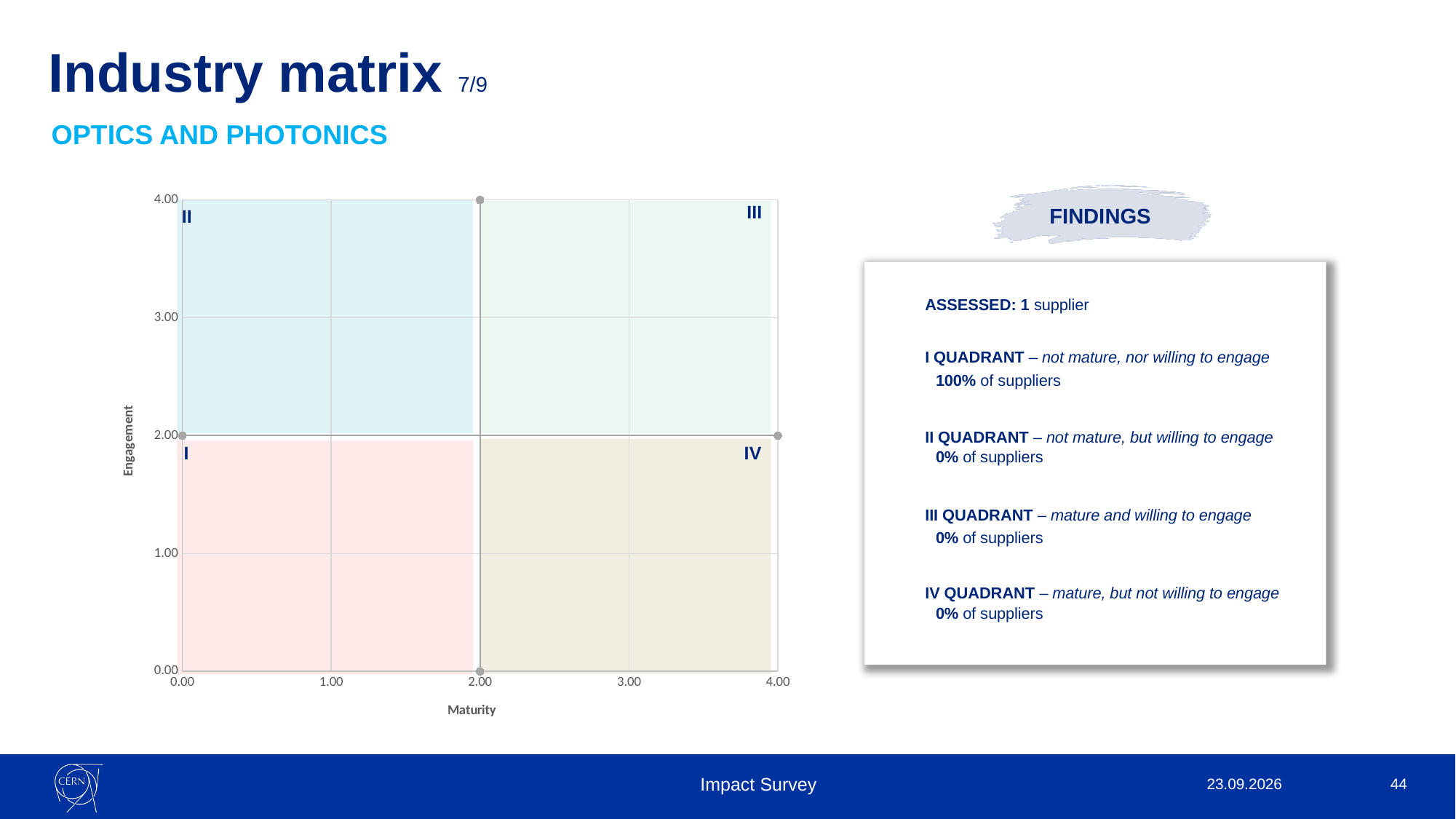
How many quadrants are labelled on the chart? 4 At what Engagement value is the horizontal dividing line between the quadrants drawn? 2.00 What kind of chart is shown on the slide? Scatter chart Which quadrant label appears in the top-right area of the chart? III At what Maturity value is the vertical dividing line between the quadrants drawn? 2.00 What is the label of the vertical axis of the chart? Engagement How many tick marks are labelled on the Maturity axis? 5 Which quadrant label appears in the bottom-left area of the chart? I What is the highest tick value shown on the Maturity axis? 4.00 What is the lowest tick value shown on the Engagement axis? 0.00 What is the label of the horizontal axis of the chart? Maturity